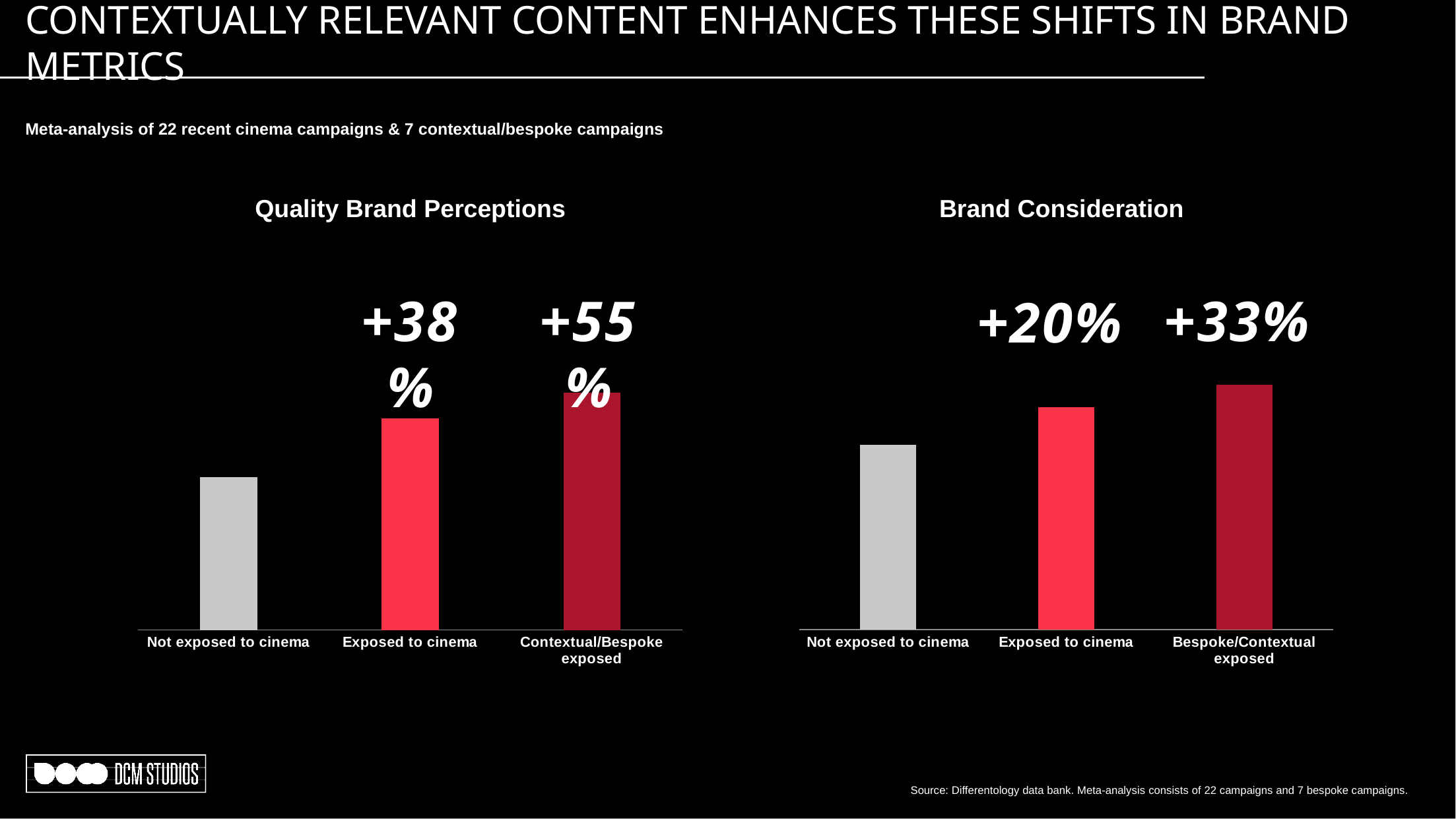
In the Brand Consideration chart, is the bar for Exposed to cinema taller or shorter than the bar for Bespoke/Contextual exposed? shorter Do the bars in the Quality Brand Perceptions chart rise or fall from left to right? rise In the Brand Consideration chart, what uplift is printed above the Exposed to cinema bar? +20% How many categories are shown on the Brand Consideration chart? 3 In the Quality Brand Perceptions chart, what uplift is printed above the Contextual/Bespoke exposed bar? +55% In the Brand Consideration chart, which category has the shortest bar? Not exposed to cinema What kind of chart is the Quality Brand Perceptions chart? bar chart In the Quality Brand Perceptions chart, how many percentage points higher is the printed uplift for Contextual/Bespoke exposed than for Exposed to cinema? 17 In the Quality Brand Perceptions chart, what uplift is printed above the Exposed to cinema bar? +38% In the Brand Consideration chart, what uplift is printed above the Bespoke/Contextual exposed bar? +33% What colour is the Not exposed to cinema bar in each chart? grey In the Quality Brand Perceptions chart, which category has the tallest bar? Contextual/Bespoke exposed